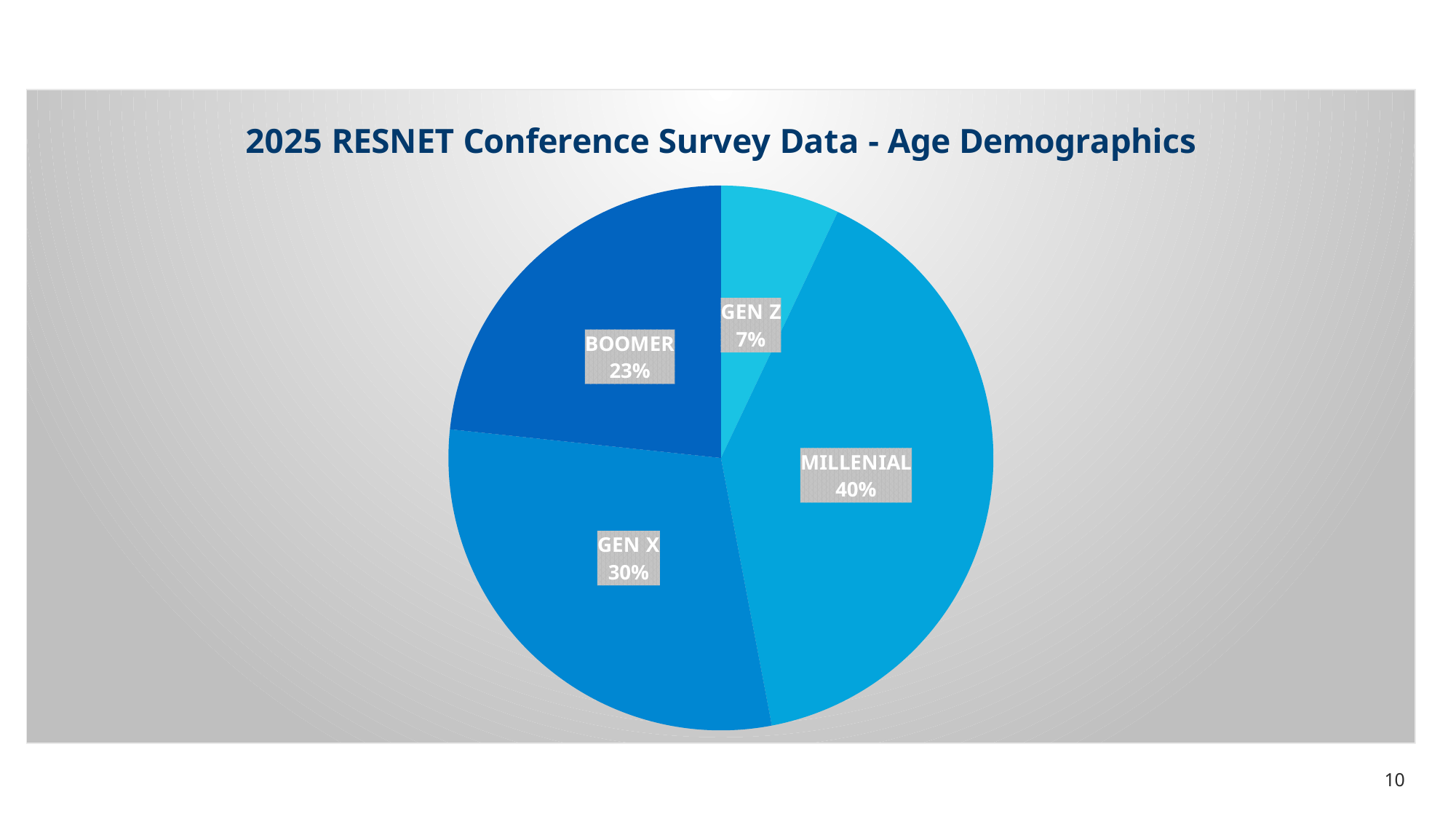
What is the difference in percentage points between the MILLENIAL and GEN X slices? 10 How many slices does the pie chart have? 4 What is the value shown for GEN Z? 7% Which is larger, the BOOMER slice or the GEN X slice? GEN X Which age group has the smallest slice of the pie? GEN Z What is the title of the chart? 2025 RESNET Conference Survey Data - Age Demographics What kind of chart is shown on the slide? pie chart Which age group has the largest slice of the pie? MILLENIAL What is the difference in percentage points between the BOOMER and GEN Z slices? 16 What share of the pie does the MILLENIAL slice represent? 40% What is the value shown for BOOMER? 23% What is the value shown for GEN X? 30%